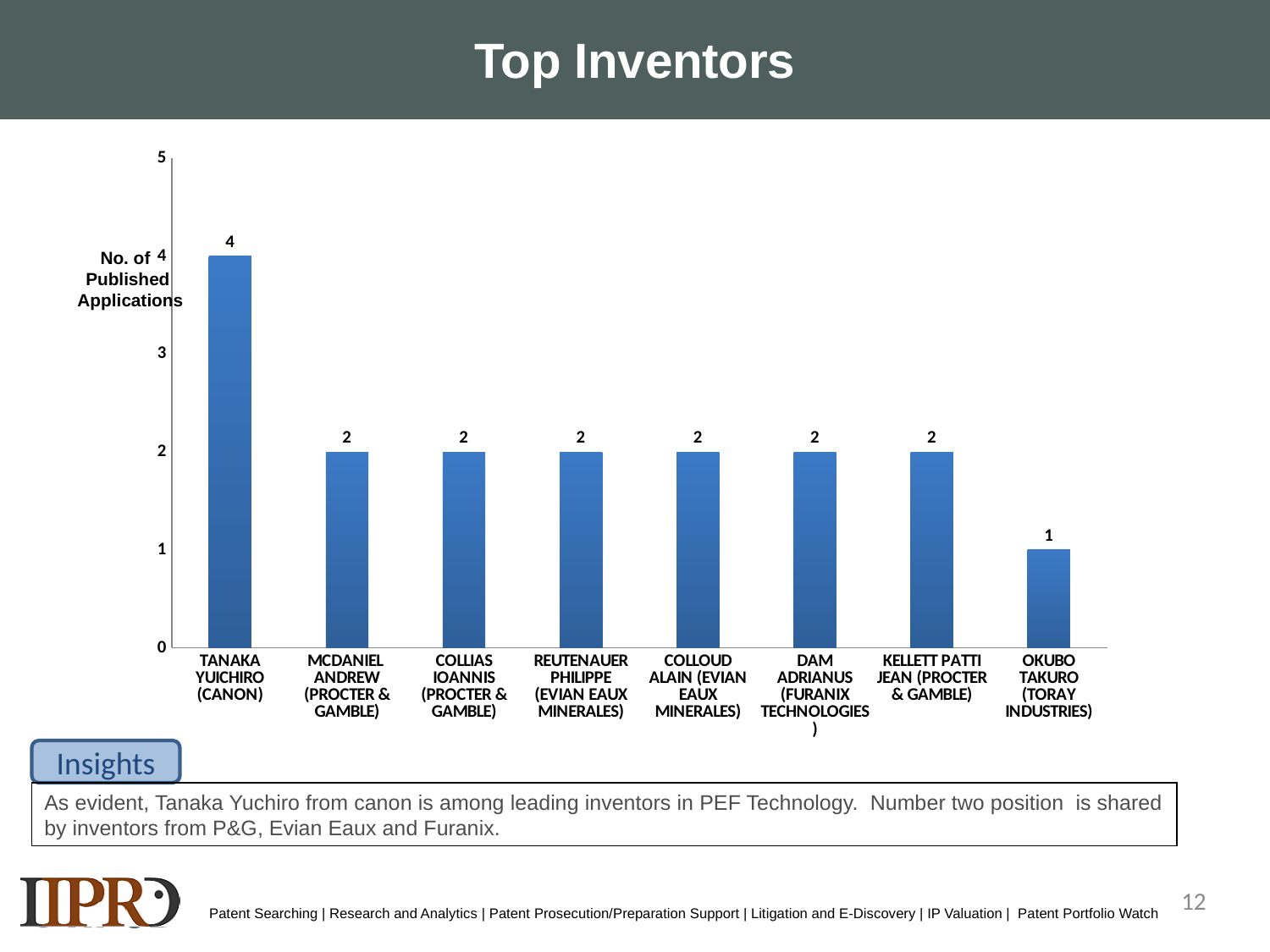
What is the number of published applications for Okubo Takuro (Toray Industries)? 1 How many inventors are shown in the chart? 8 Who has more published applications, Dam Adrianus (Furanix Technologies) or Okubo Takuro (Toray Industries)? Dam Adrianus (Furanix Technologies) What is the difference in published applications between Tanaka Yuichiro (Canon) and Collias Ioannis (Procter & Gamble)? 2 Which inventor has the highest number of published applications? Tanaka Yuichiro (Canon) Is the value for Tanaka Yuichiro (Canon) greater or less than 3? greater How many published applications does McDaniel Andrew (Procter & Gamble) have? 2 What is the title of the chart on the slide? Top Inventors What type of chart is shown on the slide? Bar chart Which inventor has the lowest number of published applications? Okubo Takuro (Toray Industries) How many inventors have exactly 2 published applications? 6 How many published applications does Tanaka Yuichiro (Canon) have? 4